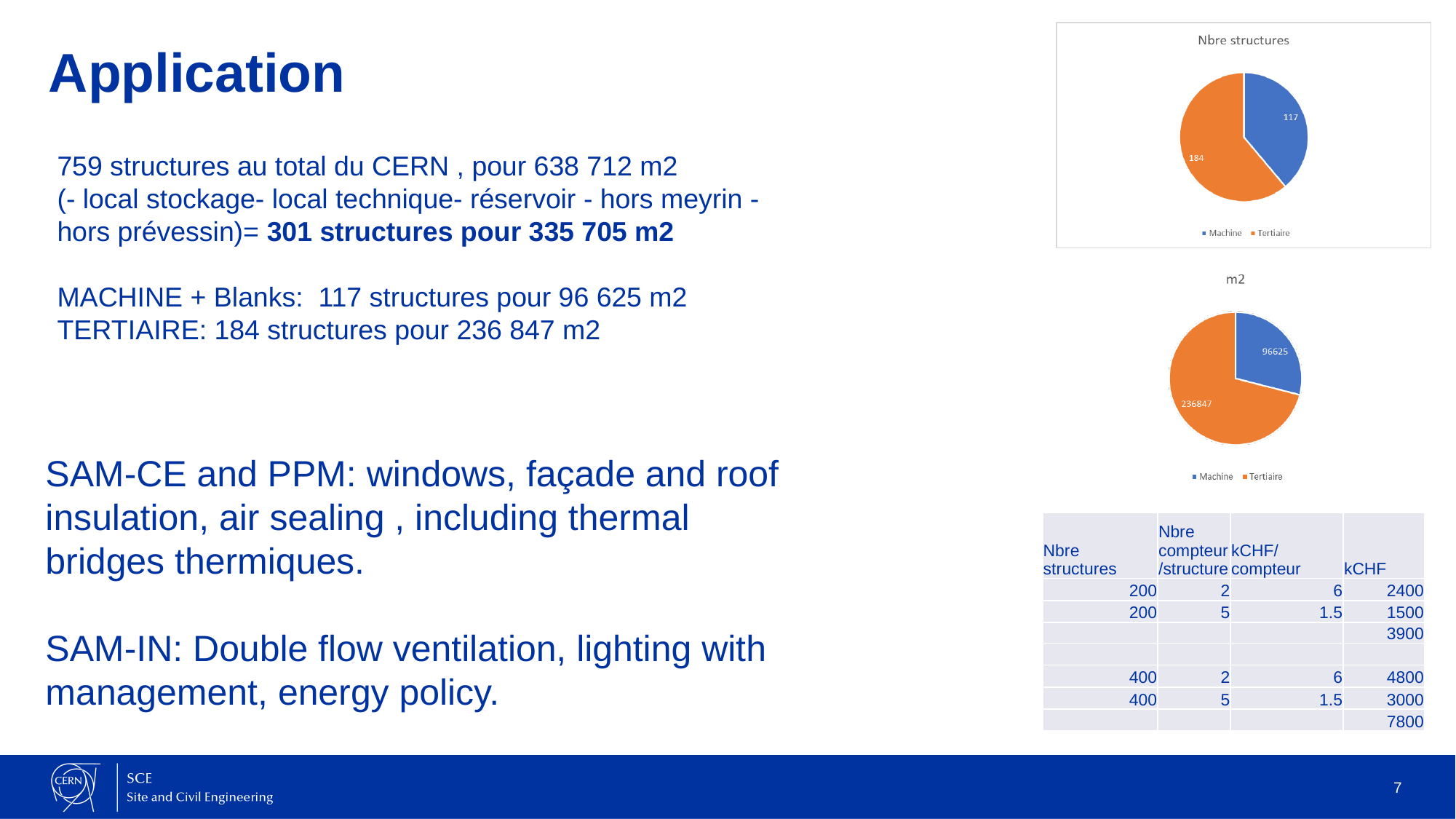
In the 'Nbre structures' pie chart, which category has the largest slice? Tertiaire How many categories does the legend of the 'm2' pie chart list? 2 In the 'Nbre structures' pie chart, what is the value for Machine? 117 In the 'Nbre structures' pie chart, what is the difference between the Tertiaire and Machine values? 67 In the 'm2' pie chart, what is the value for Machine? 96625 In the 'm2' pie chart, what is the value for Tertiaire? 236847 In the 'Nbre structures' pie chart, what colour is the Machine slice? Blue In the 'm2' pie chart, what is the difference between the Tertiaire and Machine values? 140222 In the 'm2' pie chart, which is larger, Machine or Tertiaire? Tertiaire What type of chart is the 'Nbre structures' chart? Pie chart In the 'm2' pie chart, which category has the smallest slice? Machine In the 'Nbre structures' pie chart, what is the value for Tertiaire? 184